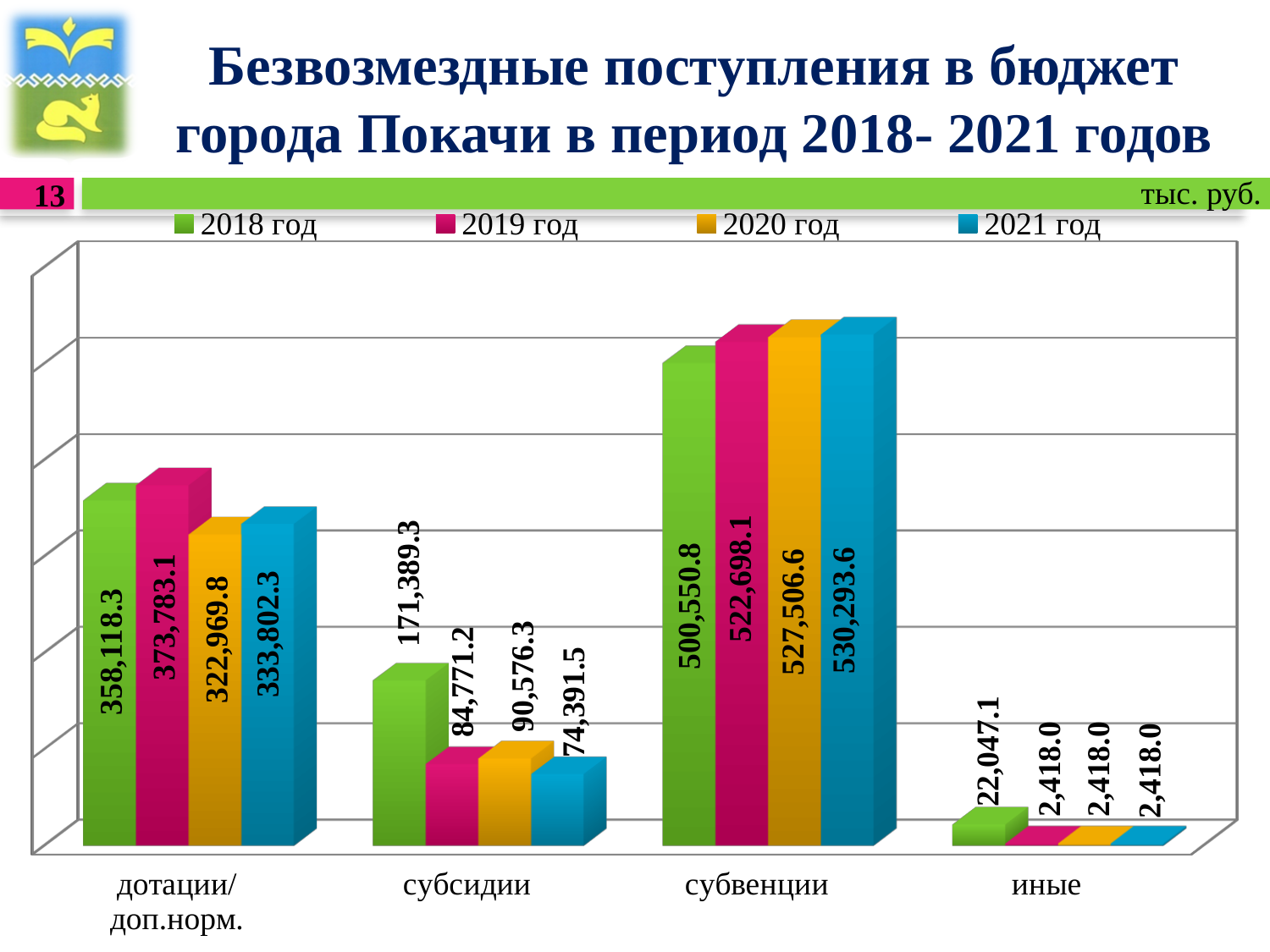
Which is larger for субсидии: the 2020 год value or the 2021 год value? 2020 год Do the values for субвенции rise or fall from 2018 год to 2021 год? rise How many categories are shown on the x axis? 4 What is the value for дотации/доп.норм. in 2020 год? 322,969.8 How many series does the legend list? 4 What is the value for субвенции in 2021 год? 530,293.6 What kind of chart is shown on the slide? bar chart What is the difference between the 2019 год and 2018 год values for дотации/доп.норм.? 15,664.8 Which category has the lowest value in 2018 год? иные What is the value for субсидии in 2018 год? 171,389.3 Which category has the highest value in 2019 год? субвенции What is the value for иные in 2019 год? 2,418.0